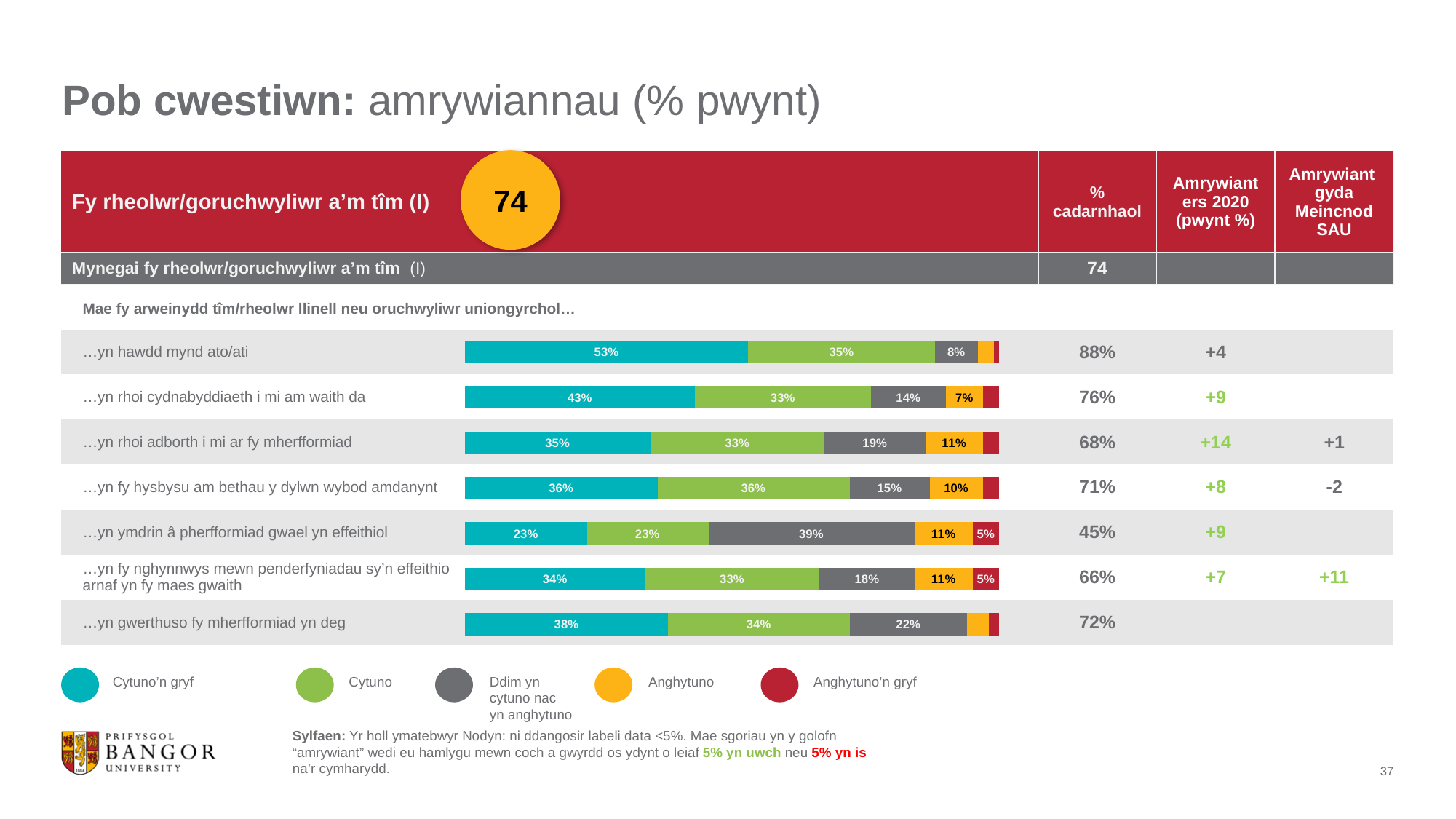
What is the 'Anghytuno' value for '…yn rhoi adborth i mi ar fy mherfformiad'? 11% Which colour represents 'Anghytuno'n gryf' in the legend? Red What is the 'Ddim yn cytuno nac yn anghytuno' value for '…yn ymdrin â pherfformiad gwael yn effeithiol'? 39% What kind of chart is used to show the responses? Stacked bar chart Which statement has the lowest 'Cytuno'n gryf' value? …yn ymdrin â pherfformiad gwael yn effeithiol What percentage of respondents strongly agree (Cytuno'n gryf) that their manager is easy to approach (…yn hawdd mynd ato/ati)? 53% What is the 'Cytuno' value for '…yn gwerthuso fy mherfformiad yn deg'? 34% How many statements (bars) are shown in the chart? 7 What is the difference between the 'Cytuno'n gryf' values for '…yn hawdd mynd ato/ati' and '…yn rhoi cydnabyddiaeth i mi am waith da'? 10% Which is larger: the 'Ddim yn cytuno nac yn anghytuno' value for '…yn gwerthuso fy mherfformiad yn deg' or for '…yn fy nghynnwys mewn penderfyniadau sy'n effeithio arnaf yn fy maes gwaith'? …yn gwerthuso fy mherfformiad yn deg How many response categories does the legend list? 5 Which statement has the highest 'Cytuno'n gryf' value? …yn hawdd mynd ato/ati